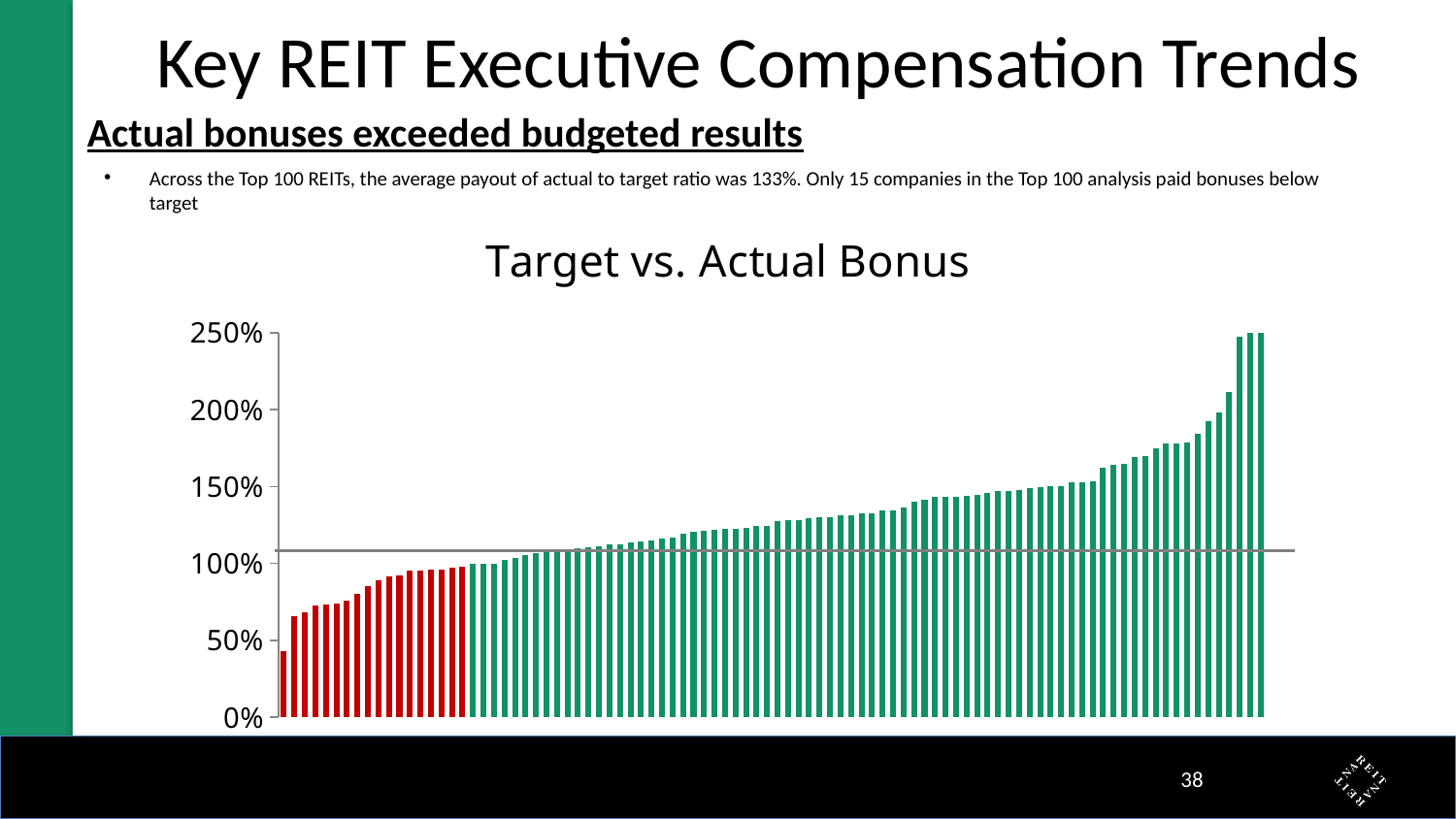
What is the title of the chart? Target vs. Actual Bonus Is the value of the rightmost (tallest) bar greater or less than 200%? greater Is the value of the tallest green bar greater or less than the value of the tallest red bar? greater Do the bar values rise or fall moving from left to right along the x axis? rise Are the red bars greater or less than 100%? less Is the value of the leftmost (shortest) bar greater or less than 50%? less Is the tallest bar on the chart at the left end or the right end? right end Is the shortest bar on the chart at the left end or the right end? left end What is the highest value shown on the vertical axis? 250% How many red bars are there in the chart? 18 What kind of chart is shown on the slide? bar chart